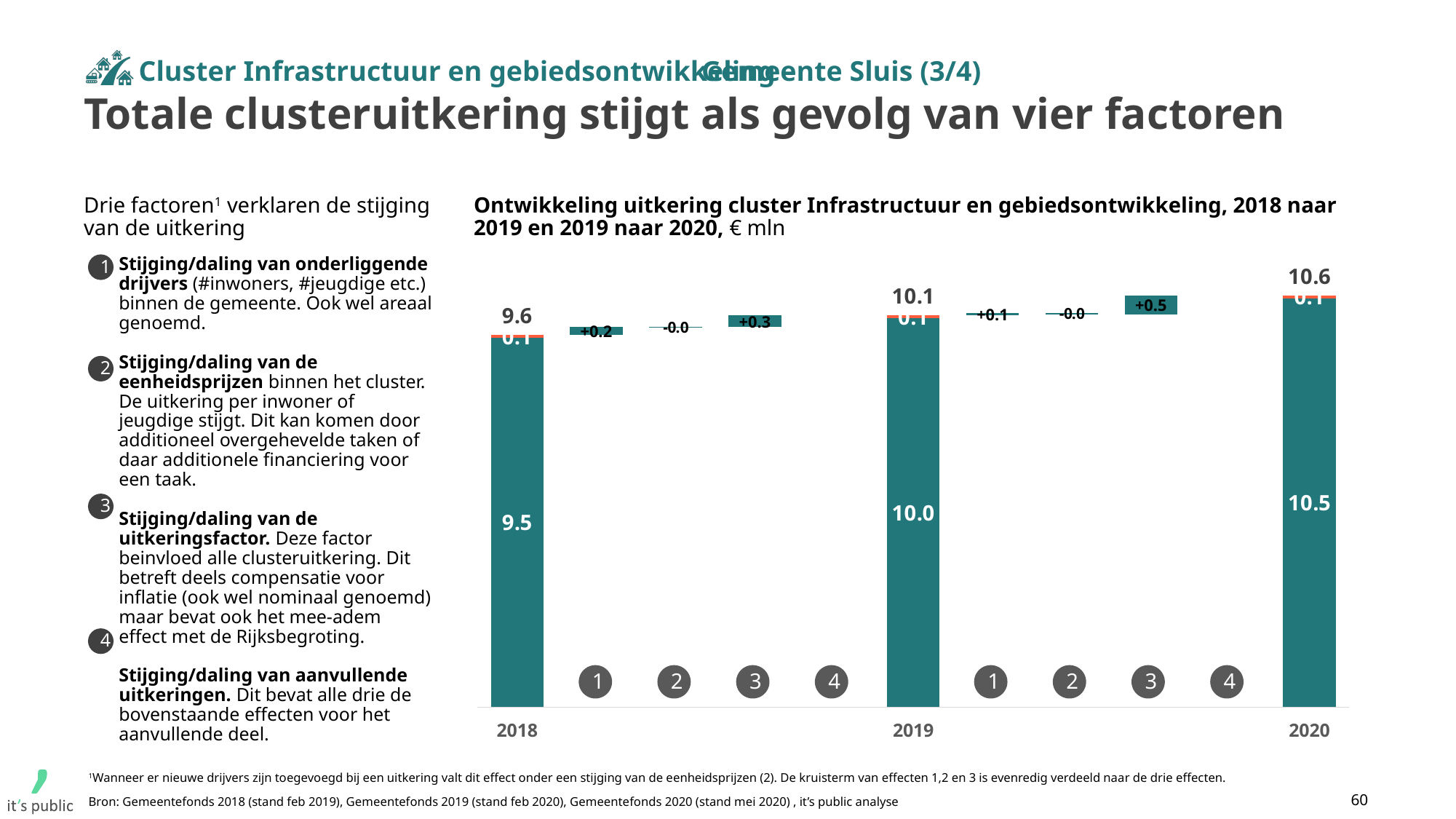
Does the total cluster payout rise or fall from 2018 to 2020? rise What is the effect of factor 3 (uitkeringsfactor) between 2019 and 2020? +0.5 What is the value of the large lower segment of the 2020 bar? 10.5 By how much does the total cluster payout increase from 2018 to 2020? 1.0 What is the effect of factor 1 between 2018 and 2019? +0.2 In what unit are the values in the chart expressed? € mln What is the total cluster payout shown for 2018? 9.6 What is the effect of factor 3 (uitkeringsfactor) between 2018 and 2019? +0.3 Which year has the highest total cluster payout? 2020 Is the total for 2019 larger or smaller than the total for 2018? larger What is the total cluster payout shown for 2020? 10.6 What is the total cluster payout shown for 2019? 10.1